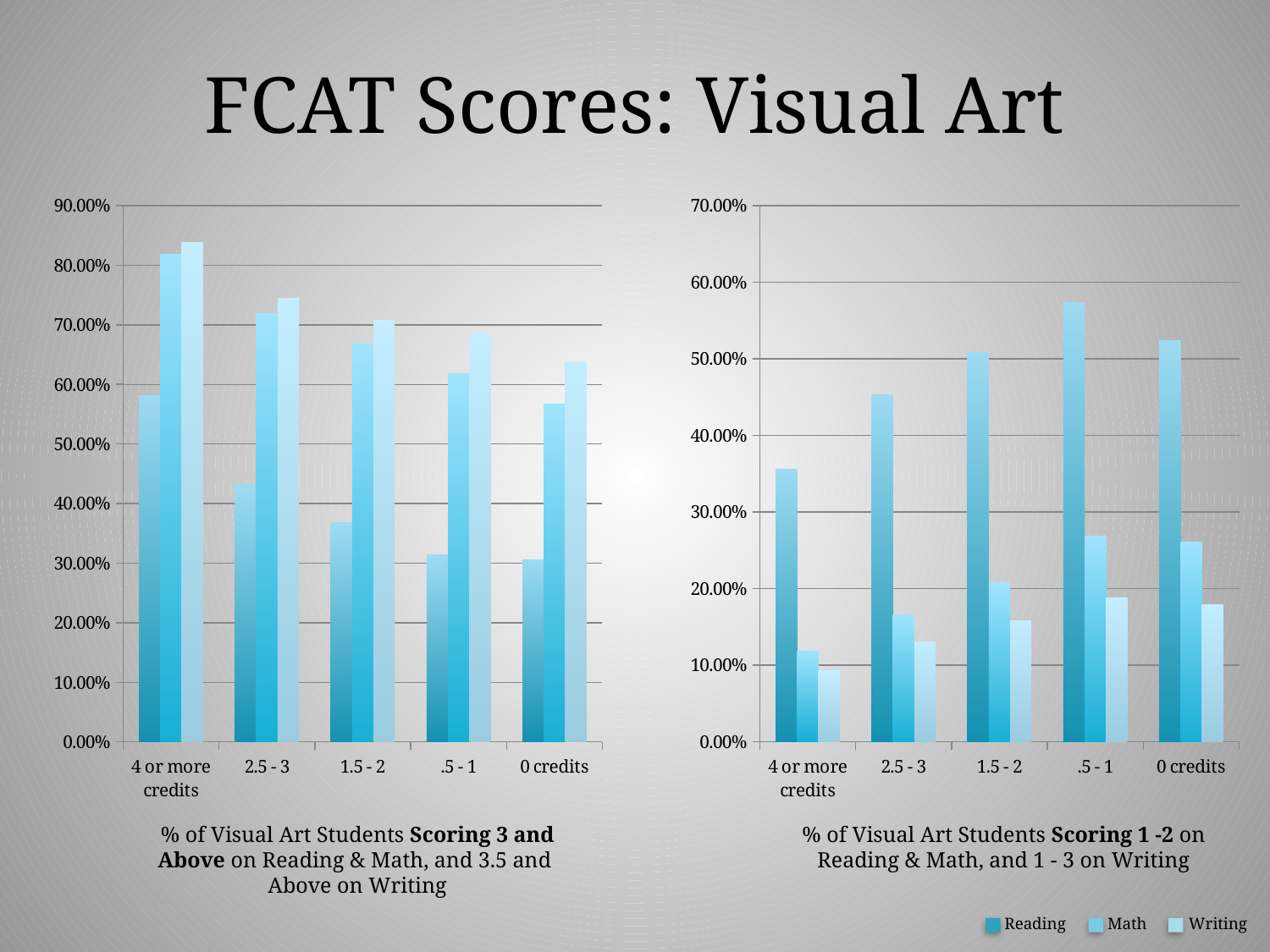
In the right chart ('Scoring 1-2'), which is larger for '2.5 - 3': Reading or Math? Reading In the left chart ('Scoring 3 and Above'), do the Math values rise or fall moving from '4 or more credits' to '0 credits'? Fall In the left chart ('Scoring 3 and Above'), is the Reading value for '4 or more credits' greater or less than 50.00%? greater In the right chart ('Scoring 1-2'), which credit category has the lowest Reading value? 4 or more credits How many series does the legend list for the charts on this slide? 3 What kind of chart is the left chart, '% of Visual Art Students Scoring 3 and Above'? Bar chart In the right chart ('Scoring 1-2'), is the Reading value for '.5 - 1' greater or less than 50.00%? greater How many credit categories are shown on the x axis of the right chart, '% of Visual Art Students Scoring 1-2'? 5 In the left chart ('Scoring 3 and Above'), which credit category has the highest Reading value? 4 or more credits What is the title of the slide? FCAT Scores: Visual Art In the left chart ('Scoring 3 and Above'), is the Math value for '0 credits' greater or less than 60.00%? less